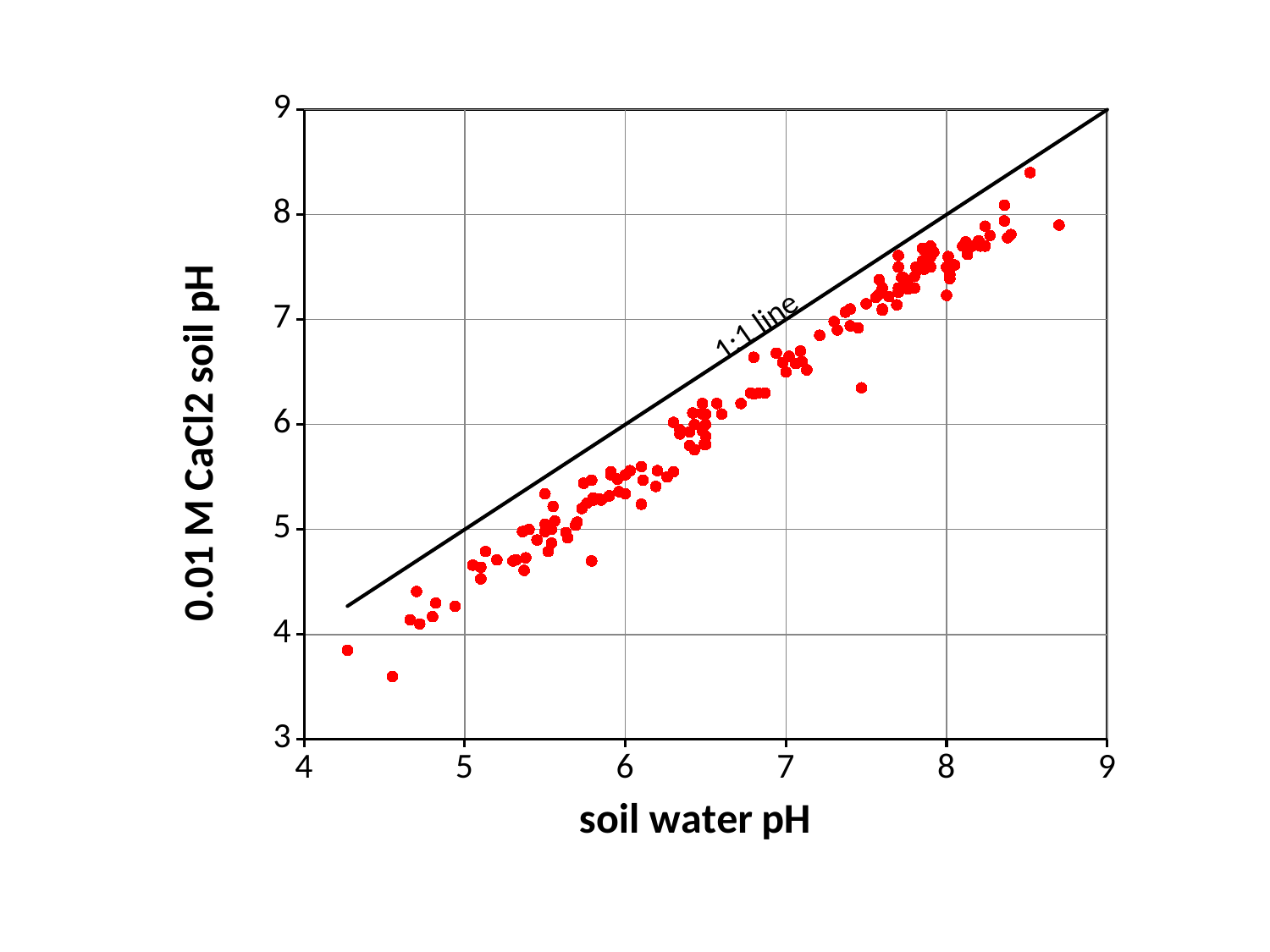
Is the 0.01 M CaCl2 soil pH of the highest plotted point greater or less than 8? greater What kind of chart is shown on the slide? scatter plot Do the plotted 0.01 M CaCl2 soil pH values rise or fall as soil water pH increases along the x axis? rise Is the soil water pH of the lowest plotted point greater or less than 5? less Is the 0.01 M CaCl2 soil pH of the lowest plotted point greater or less than 4? less What is the title of the y axis? 0.01 M CaCl2 soil pH What is the maximum value shown on the y axis? 9 What is the title of the x axis? soil water pH Do most of the plotted points lie above or below the 1:1 line? below